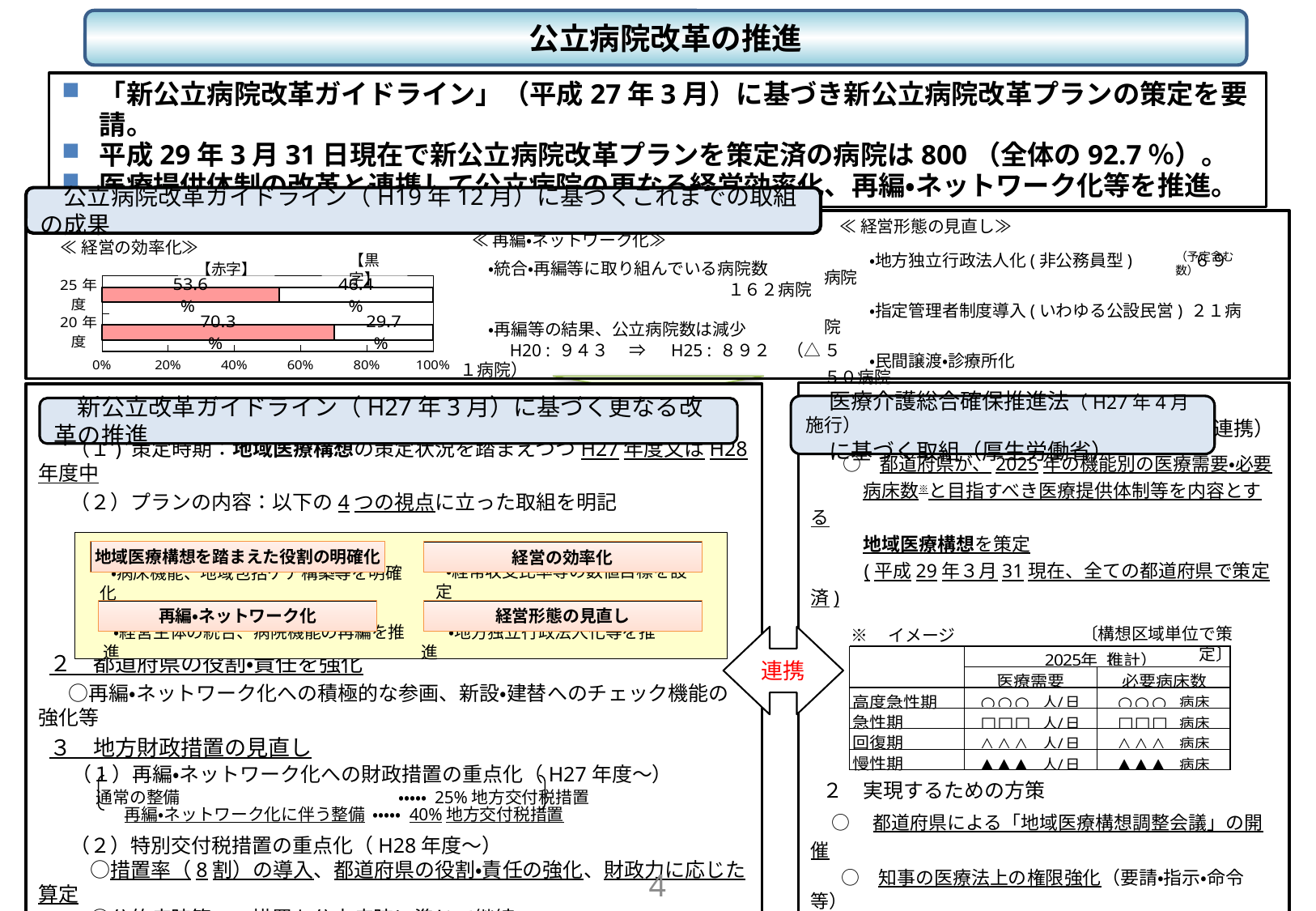
What type of chart is shown under ≪経営の効率化≫? bar chart In the ≪経営の効率化≫ chart, what is the 黒字 value for 25年度? 46.4% In the ≪経営の効率化≫ chart, what is the 黒字 value for 20年度? 29.7% In the ≪経営の効率化≫ chart, what is the 赤字 value for 25年度? 53.6% In the ≪経営の効率化≫ chart, which colour represents 赤字? red (pink) In the ≪経営の効率化≫ chart, which year has the higher 黒字 share, 25年度 or 20年度? 25年度 In the ≪経営の効率化≫ chart, which year has the higher 赤字 share, 25年度 or 20年度? 20年度 How many year categories are shown in the ≪経営の効率化≫ chart? 2 In the ≪経営の効率化≫ chart, what is the 赤字 value for 20年度? 70.3% How many series does the ≪経営の効率化≫ chart show? 2 In the ≪経営の効率化≫ chart, what is the difference between the 赤字 values for 20年度 and 25年度? 16.7% In the ≪経営の効率化≫ chart, what is the total of the 赤字 and 黒字 values for 25年度? 100%